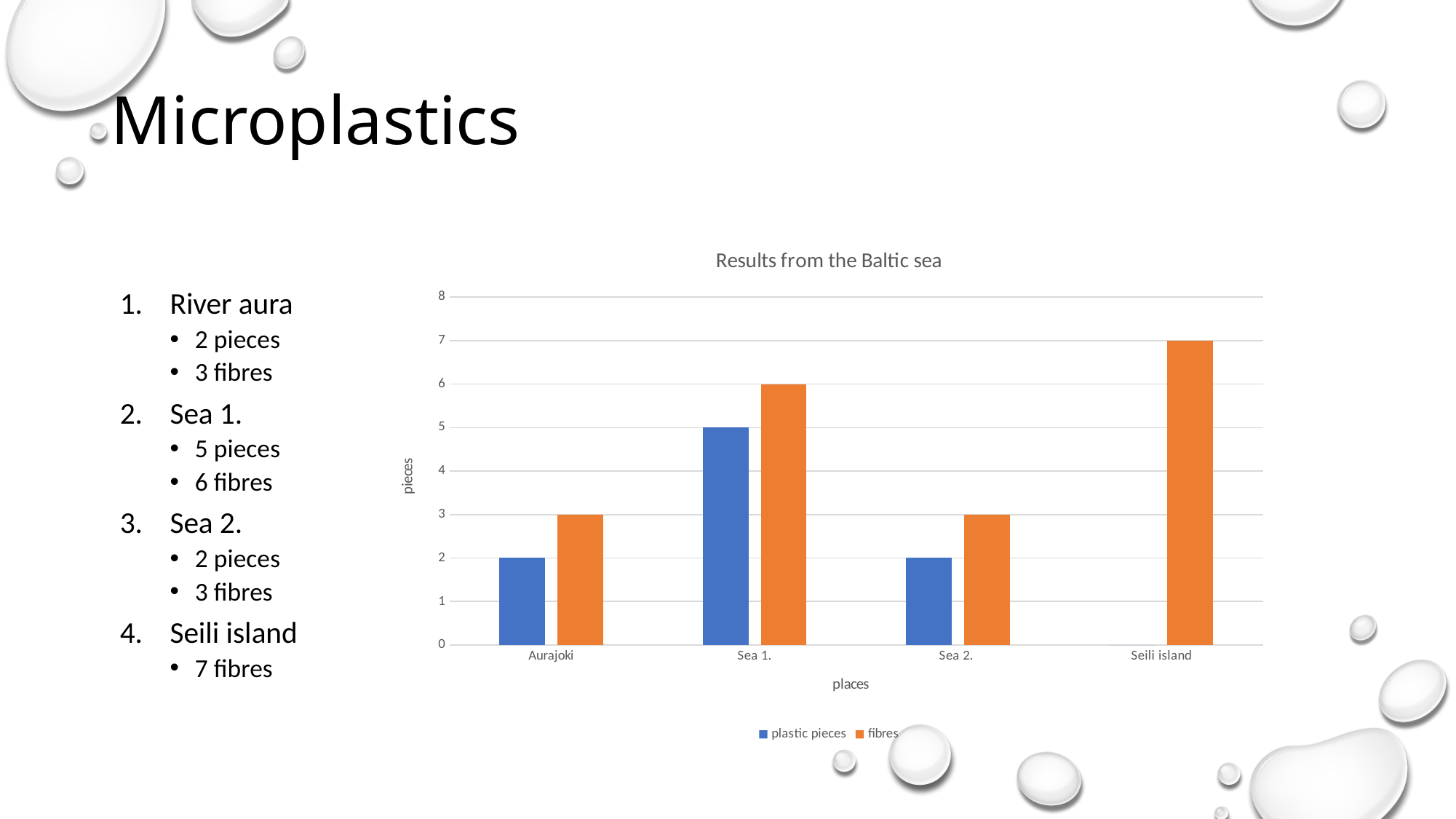
Which place has the highest value for plastic pieces? Sea 1. What is the value for fibres at Seili island? 7 What kind of chart is shown on the slide? bar chart What is the value for fibres at Aurajoki? 3 What is the title of the chart? Results from the Baltic sea How many places are shown on the x axis? 4 Which is larger at Sea 2., plastic pieces or fibres? fibres How many series does the legend list? 2 What is the value for plastic pieces at Sea 1.? 5 What is the difference between fibres and plastic pieces at Sea 1.? 1 Which place has the highest value for fibres? Seili island Is the value for fibres at Seili island greater or less than 6? greater